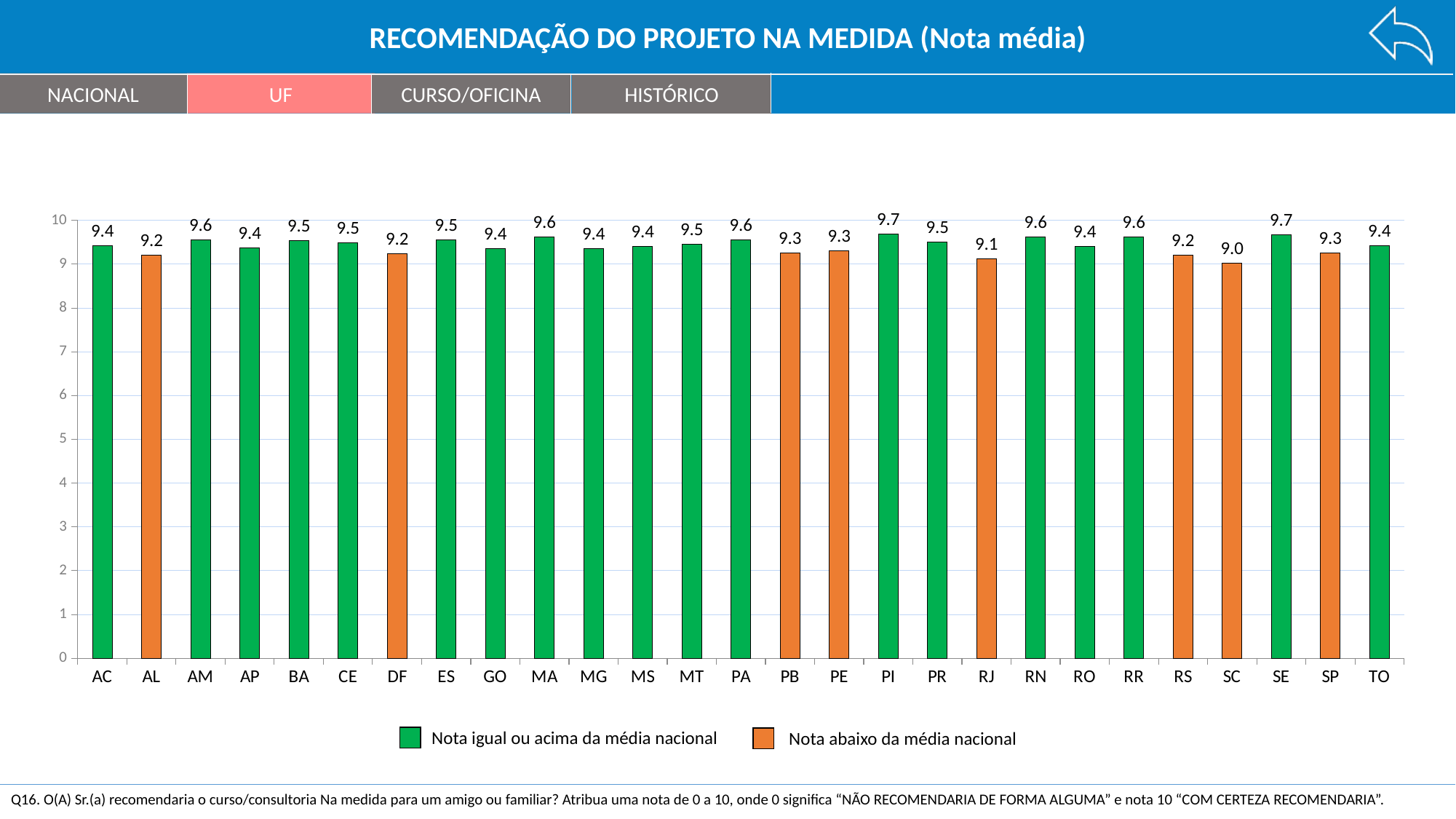
What is the difference between the values for SE and SC? 0.7 What is the value for PI? 9.7 What kind of chart is shown? bar chart How many states are shown on the x axis? 27 Which has a higher value, AM or AL? AM How many entries does the legend list? 2 Which state has the lowest value? SC What is the value for RJ? 9.1 What is the value for DF? 9.2 What does the orange colour represent according to the legend? Nota abaixo da média nacional What is the value for SC? 9.0 Is the value for RS greater or less than 8? greater